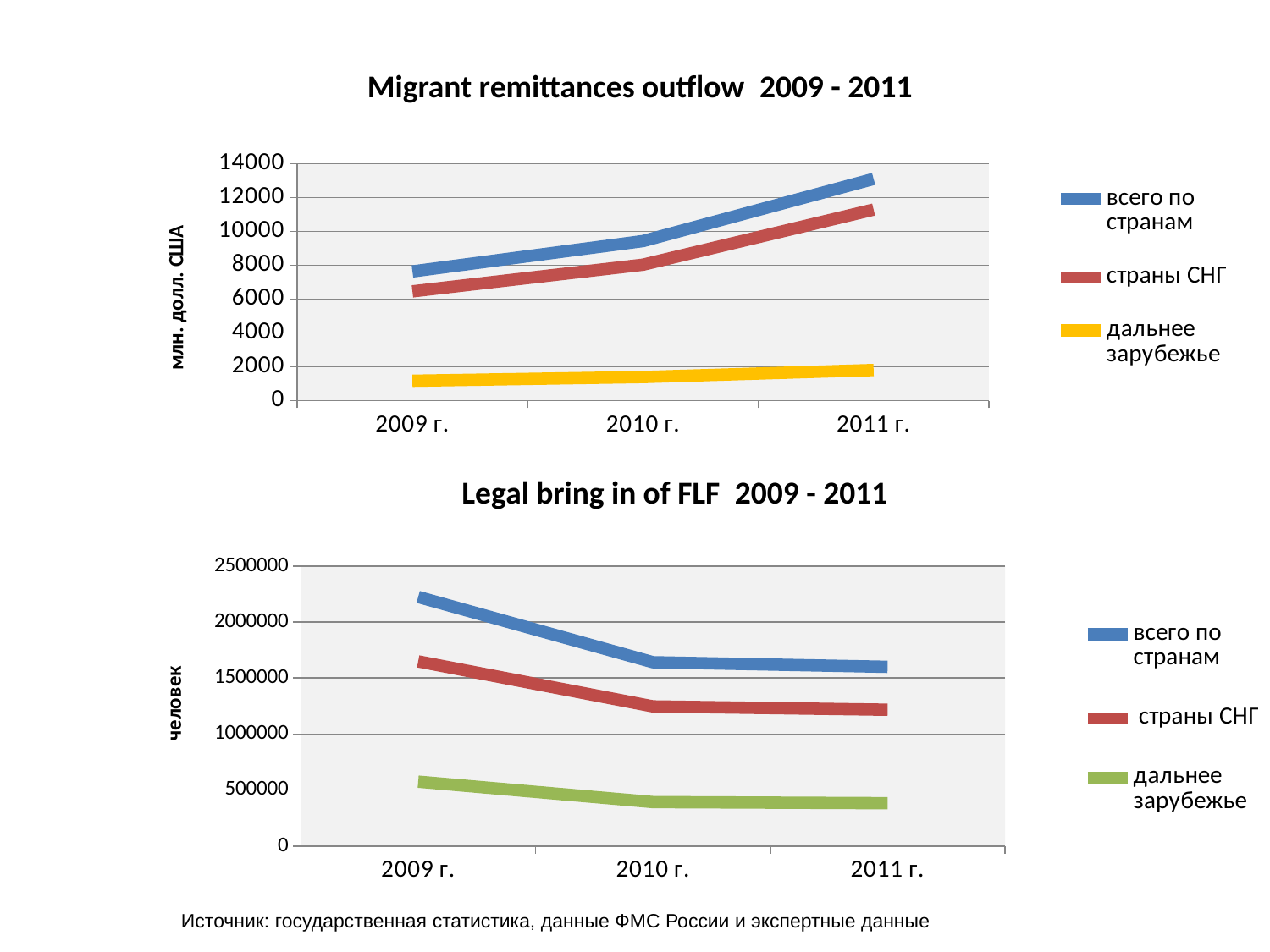
In the 'Migrant remittances outflow 2009 - 2011' chart, is the value for 'всего по странам' in 2011 г. greater or less than 12000? greater In the 'Migrant remittances outflow 2009 - 2011' chart, do the values for 'всего по странам' rise or fall from 2009 to 2011? rise In the 'Migrant remittances outflow 2009 - 2011' chart, is the value for 'дальнее зарубежье' in 2009 г. greater or less than 2000? less How many years are shown on the x axis of the 'Legal bring in of FLF 2009 - 2011' chart? 3 In the 'Migrant remittances outflow 2009 - 2011' chart, which series has the lowest values across all years? дальнее зарубежье In the 'Legal bring in of FLF 2009 - 2011' chart, do the values for 'всего по странам' rise or fall from 2009 to 2011? fall In the 'Legal bring in of FLF 2009 - 2011' chart, is the value for 'всего по странам' in 2009 г. greater or less than 2000000? greater How many series does the legend of the 'Migrant remittances outflow 2009 - 2011' chart list? 3 What is the y-axis label of the 'Legal bring in of FLF 2009 - 2011' chart? человек What type of chart is the 'Migrant remittances outflow 2009 - 2011' chart? line chart In the 'Legal bring in of FLF 2009 - 2011' chart, which year has the highest value for 'страны СНГ'? 2009 г.